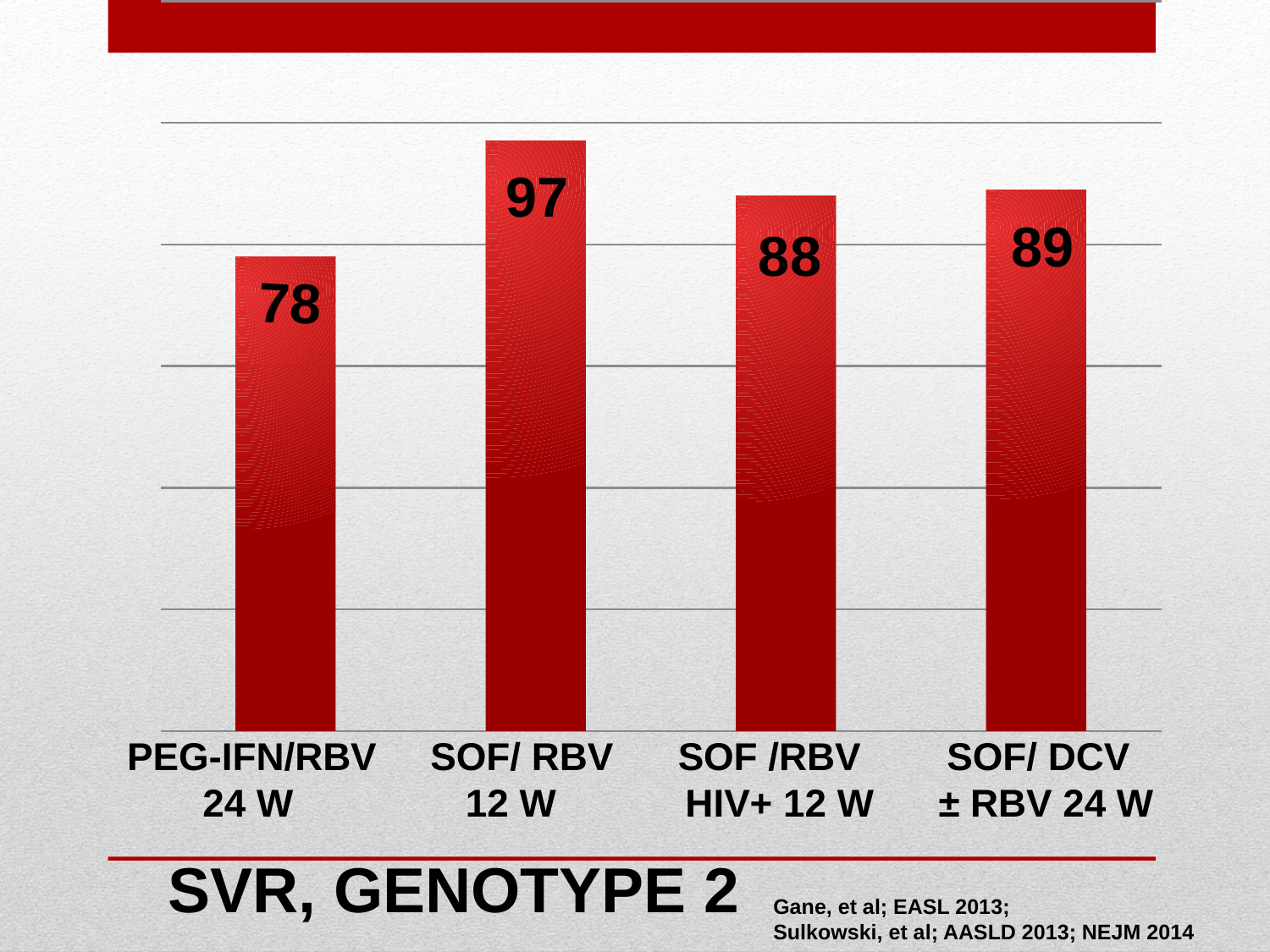
What is the SVR value for SOF/ DCV ± RBV 24 W? 89 Which has a higher SVR value, SOF /RBV HIV+ 12 W or PEG-IFN/RBV 24 W? SOF /RBV HIV+ 12 W What is the SVR value for SOF /RBV HIV+ 12 W? 88 What is the difference between the SVR values for SOF/ RBV 12 W and PEG-IFN/RBV 24 W? 19 What is the title of the chart? SVR, GENOTYPE 2 Which regimen has the highest SVR value? SOF/ RBV 12 W What kind of chart is shown on the slide? Bar chart What is the difference between the SVR values for SOF/ DCV ± RBV 24 W and SOF /RBV HIV+ 12 W? 1 How many regimens are shown in the chart? 4 Which regimen has the lowest SVR value? PEG-IFN/RBV 24 W What is the SVR value for SOF/ RBV 12 W? 97 What is the SVR value for PEG-IFN/RBV 24 W? 78